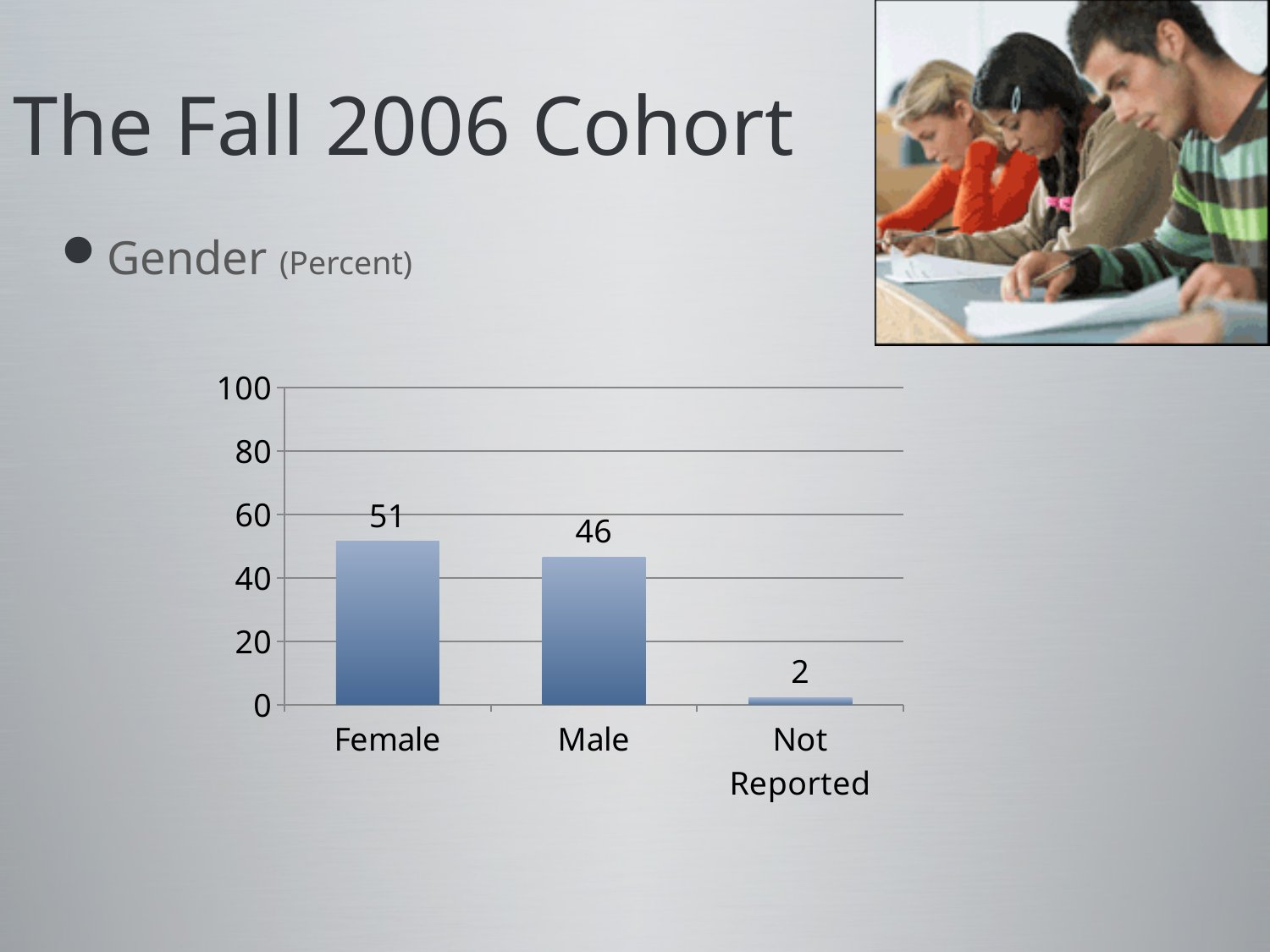
What is the value for Male? 46 Which category has the highest value? Female Is the value for Male greater or less than 60? less What is the difference between the values for Male and Not Reported? 44 What is the difference between the values for Female and Male? 5 Do the values rise or fall from left to right along the x axis? fall Which is larger, the value for Female or the value for Male? Female How many categories are shown on the x axis? 3 What is the value for Not Reported? 2 What is the value for Female? 51 What kind of chart is shown on the slide? bar chart Which category has the lowest value? Not Reported